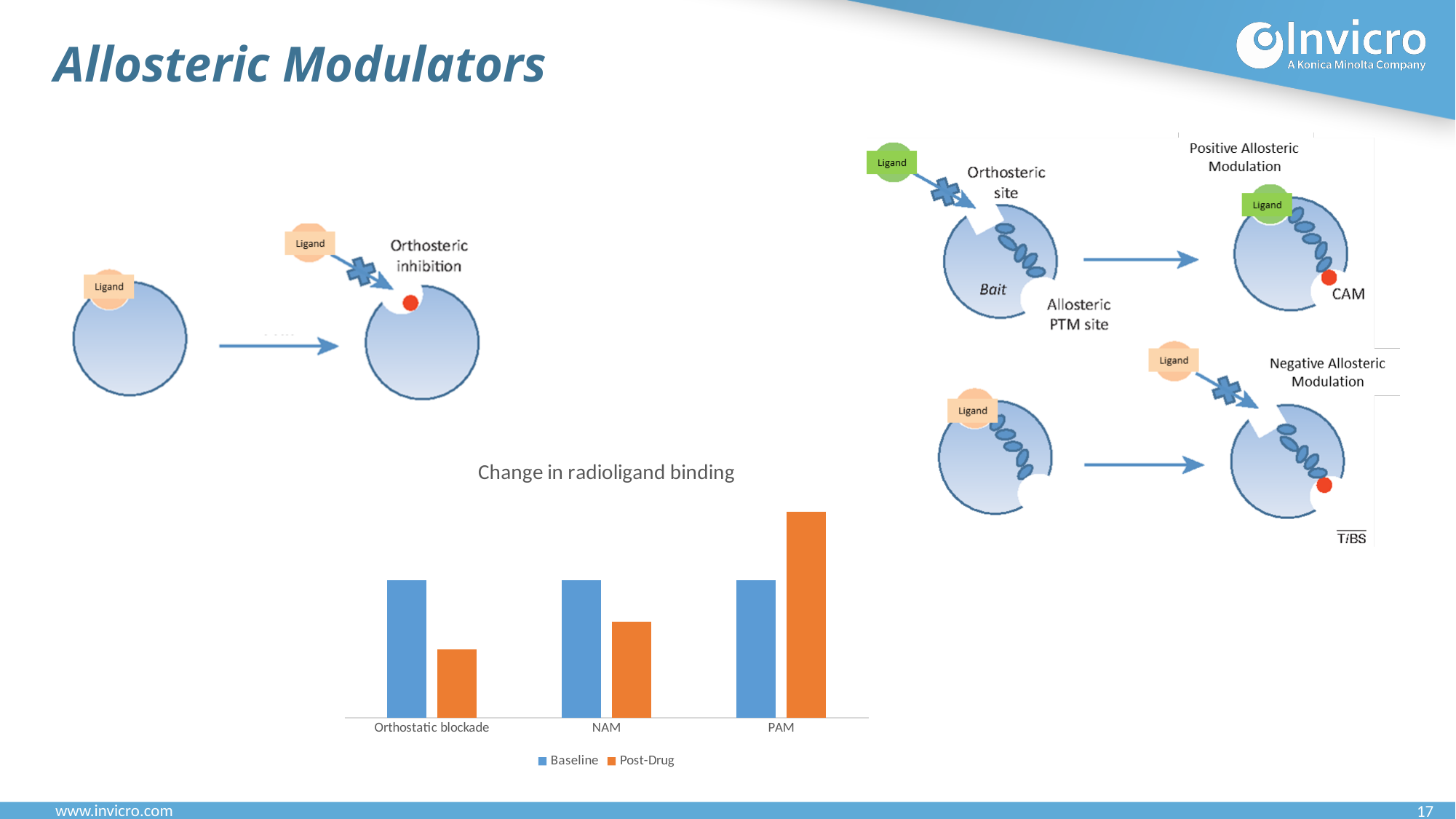
For Orthostatic blockade, which is larger: Baseline or Post-Drug? Baseline For NAM, which is larger: Baseline or Post-Drug? Baseline Is the Post-Drug value for PAM larger or smaller than the Post-Drug value for NAM? larger What kind of chart is shown on the slide? bar chart Do the Post-Drug values rise or fall moving from Orthostatic blockade to PAM along the x axis? rise Which category has the highest Post-Drug value? PAM How many series does the chart legend list? 2 What is the title of the chart? Change in radioligand binding How many categories are shown on the x axis of the chart? 3 What are the two series named in the chart legend? Baseline and Post-Drug Which category has the lowest Post-Drug value? Orthostatic blockade